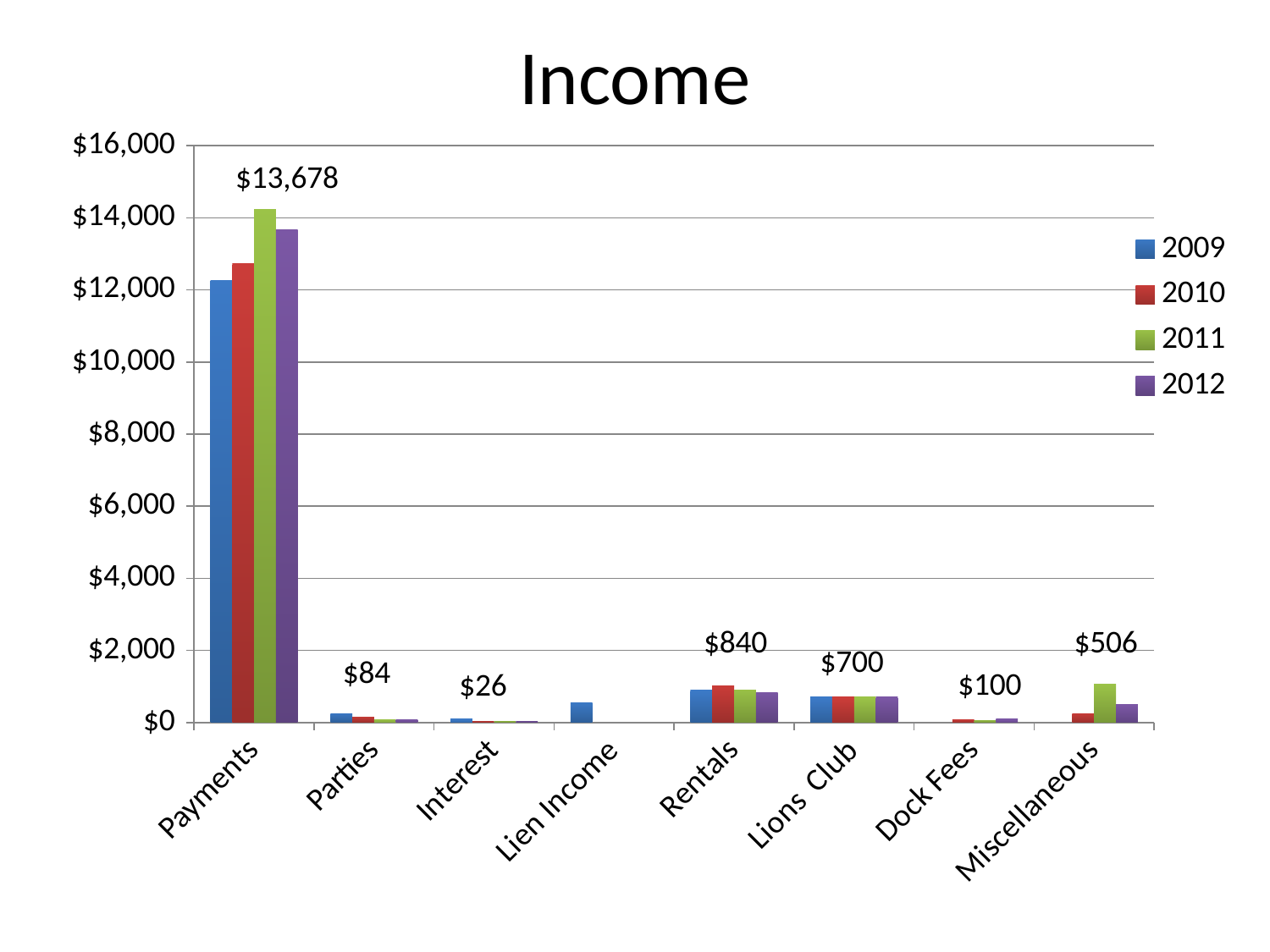
What is the labelled 2012 value for Payments? $13,678 Is the 2009 value for Lien Income greater or less than $1,000? less How many income categories are shown on the x axis? 8 What is the labelled 2012 value for Miscellaneous? $506 Which years are listed in the legend? 2009, 2010, 2011, 2012 What is the difference between the 2012 values for Rentals and Lions Club? $140 Is the 2009 value for Payments greater or less than $10,000? greater How many series does the legend list? 4 Which year had the highest Payments value? 2011 Which category has the highest income values? Payments What is the labelled 2012 value for Rentals? $840 What kind of chart is shown on the slide? bar chart